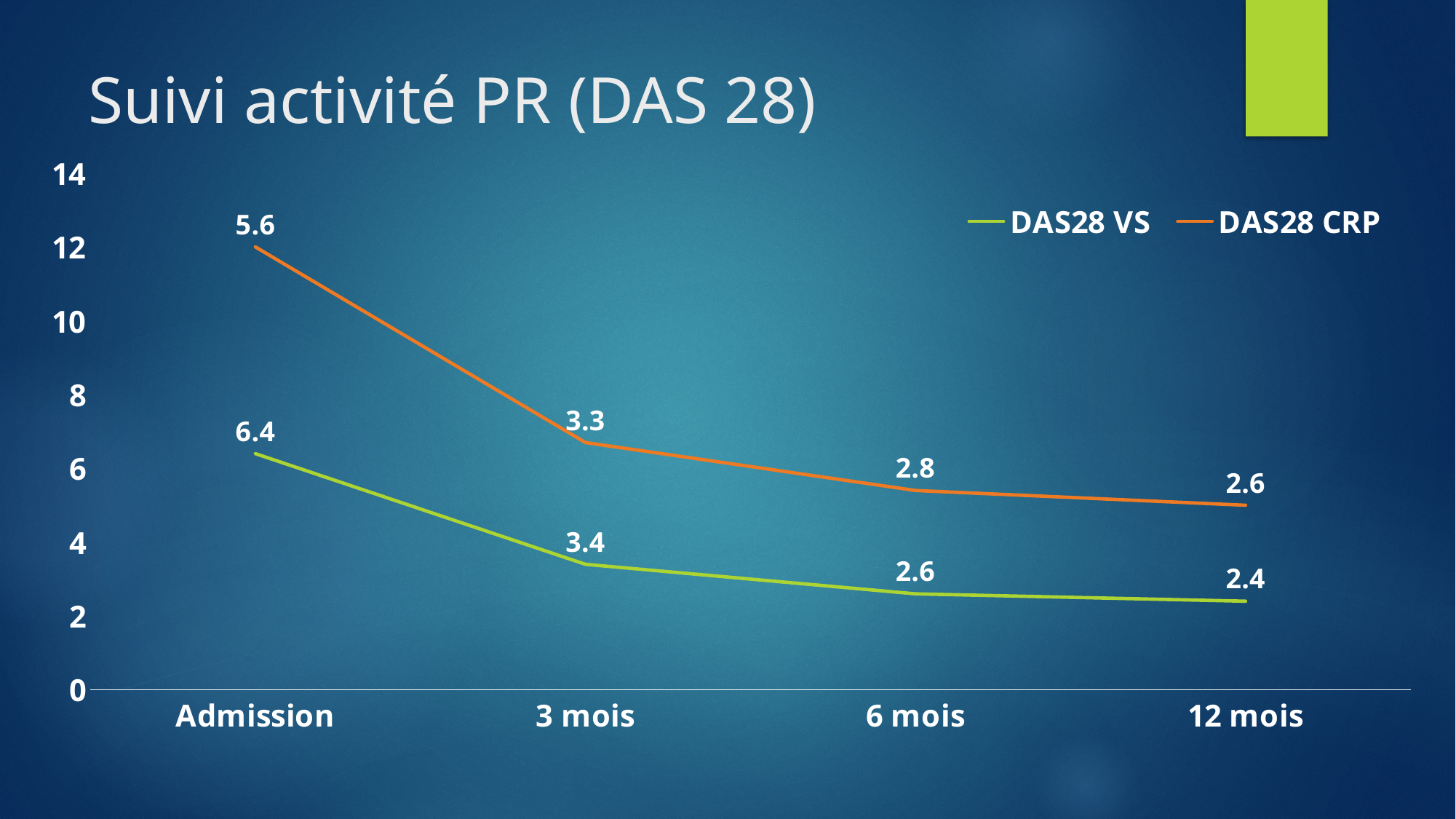
What is the DAS28 CRP value at 3 mois? 3.3 What is the DAS28 CRP value at 6 mois? 2.8 What is the difference between the DAS28 VS value at Admission and at 3 mois? 3.0 Do the DAS28 CRP values rise or fall from Admission to 12 mois? Fall At which time point is the DAS28 VS value highest? Admission What kind of chart is shown on the slide? Line chart What is the DAS28 VS value at 12 mois? 2.4 How many time points are shown on the x axis? 4 What is the DAS28 VS value at Admission? 6.4 Which is larger at Admission: the DAS28 VS value or the DAS28 CRP value? DAS28 VS How many series does the legend list? 2 At which time point is the DAS28 CRP value lowest? 12 mois